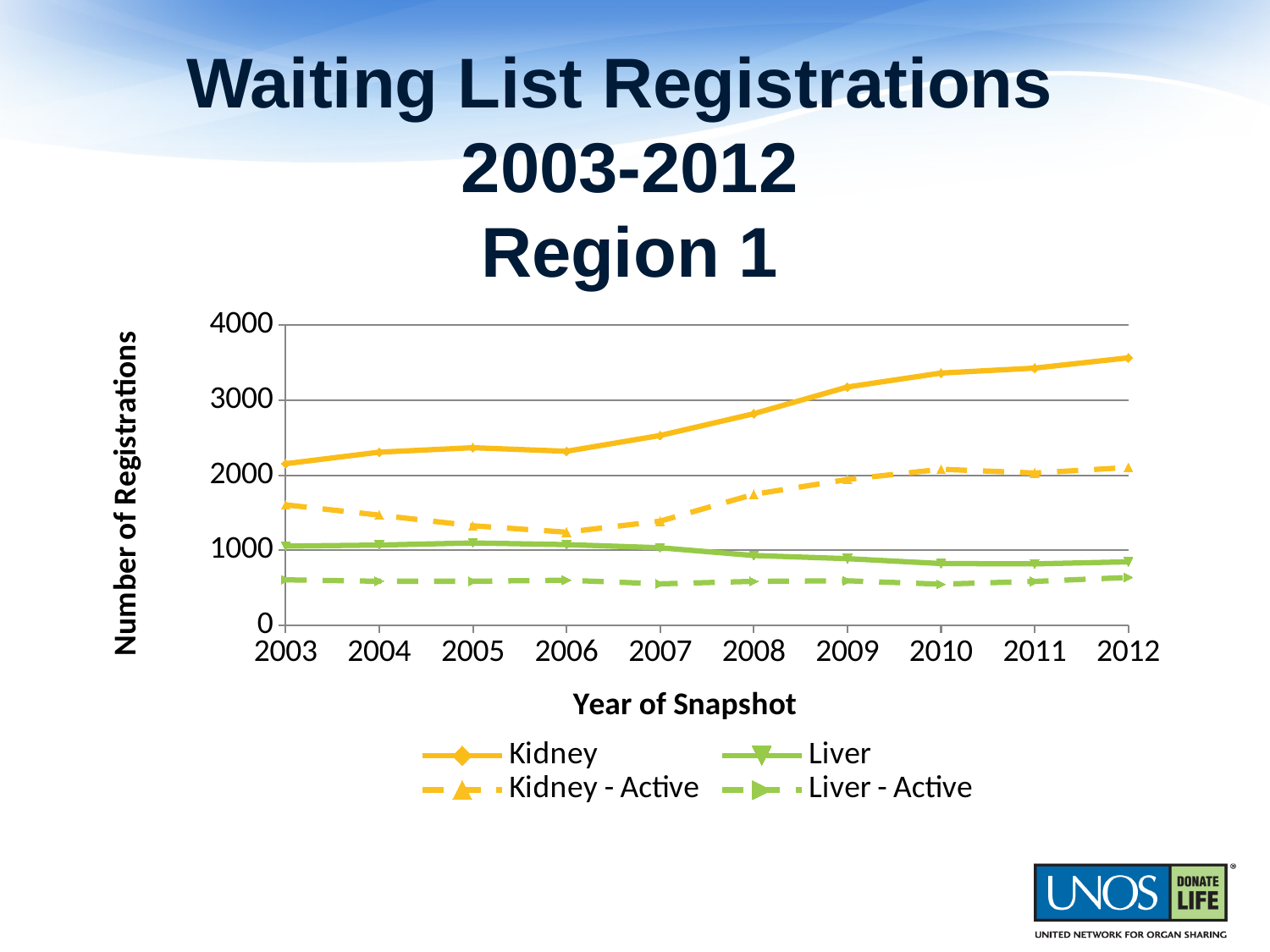
How many years are plotted along the x axis? 10 Is the value for Kidney in 2008 greater or less than 3000? less Is the value for Kidney in 2012 greater or less than 3000? greater Is the value for Liver - Active in 2003 greater or less than 1000? less Does the Liver series rise or fall from 2003 to 2012? Fall What is the label of the y axis? Number of Registrations How many series does the legend list? 4 In which year is the Kidney series at its highest? 2012 Does the Kidney series rise or fall from 2003 to 2012? Rise In 2012, which is larger, the Kidney value or the Liver value? Kidney What kind of chart is shown on the slide? Line chart In which year is the Kidney - Active series at its lowest? 2006